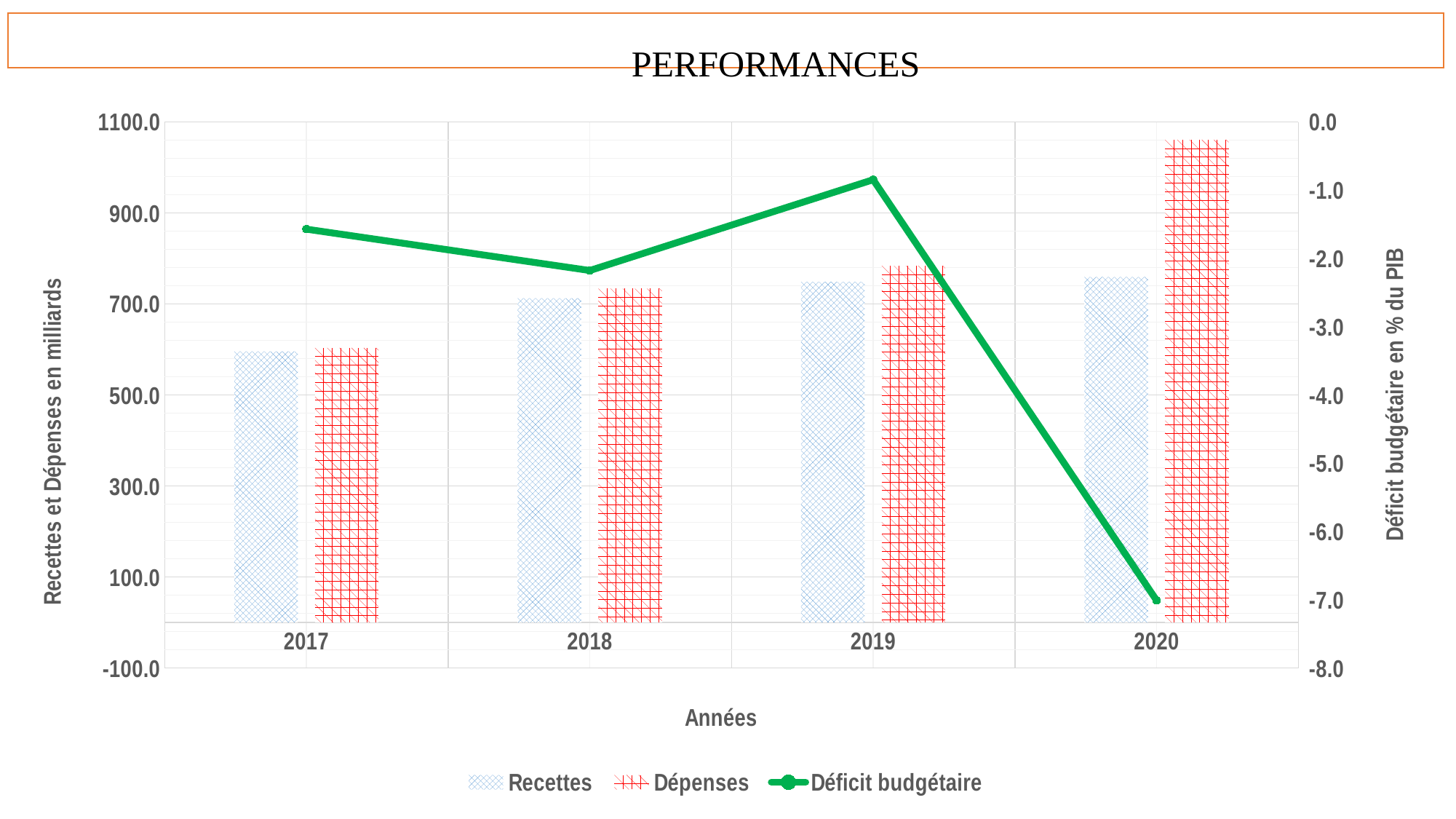
Do the Dépenses bars rise or fall from 2017 to 2020? rise How many series does the legend list? 3 In which year is the Dépenses bar the highest? 2020 How many years are shown on the x axis? 4 Is the Déficit budgétaire value for 2020 greater or less than -6.0? less In which year does the Déficit budgétaire line reach its lowest point? 2020 In which year is the Recettes bar the lowest? 2017 Is the Dépenses value for 2020 greater or less than 900.0? greater In 2020, which is larger, Recettes or Dépenses? Dépenses What kind of chart is shown on the slide? A combined bar and line chart What is the title of the x axis? Années Is the Recettes value for 2017 greater or less than 700.0? less